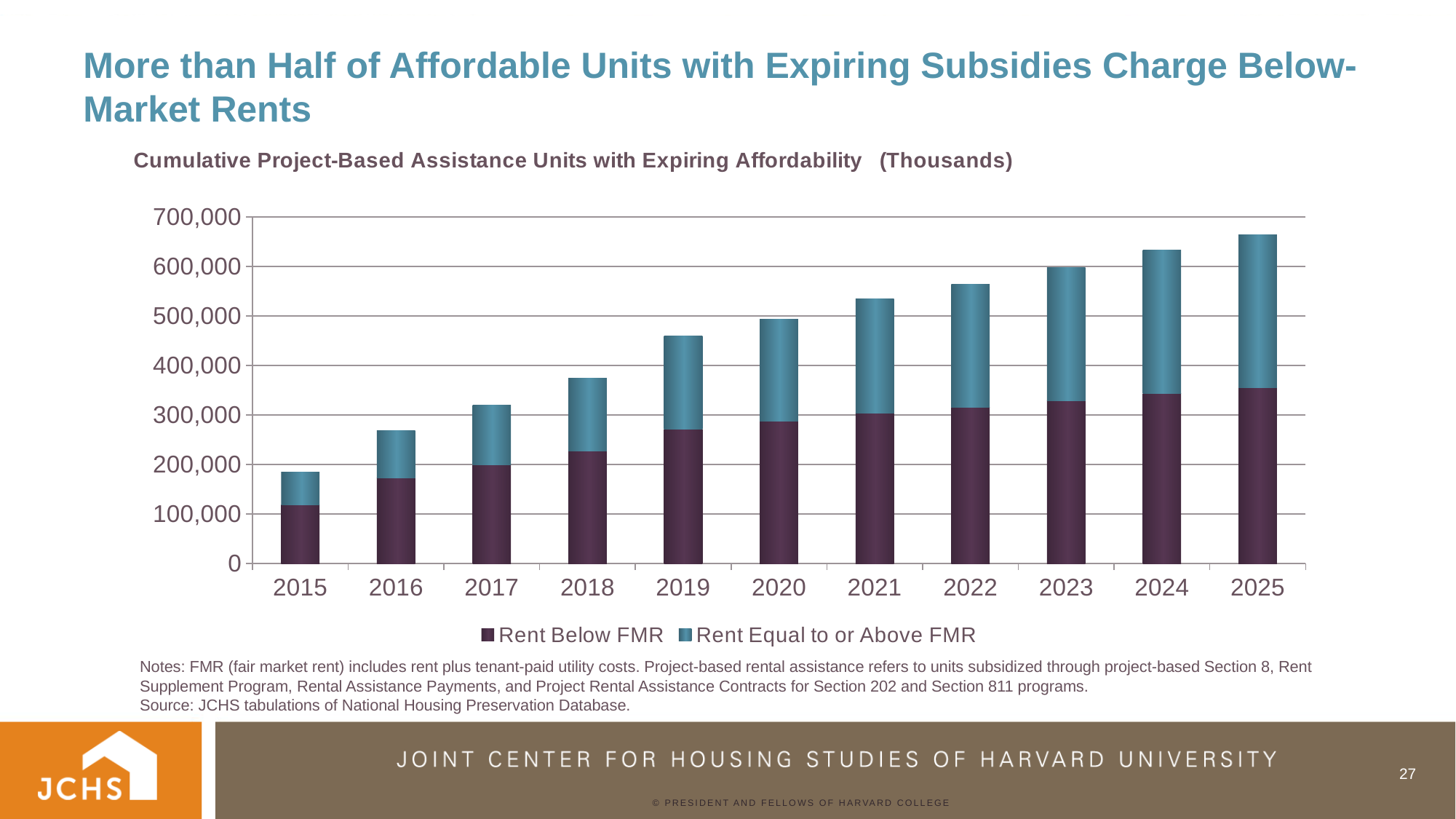
Is the total value for 2015 greater or less than 200,000? less Is the Rent Below FMR value for 2016 greater or less than 200,000? less How many years are shown on the x axis? 11 Is the Rent Below FMR value for 2025 greater or less than 300,000? greater Do the total bar heights rise or fall from 2015 to 2025? rise Which series is shown in the darker purple colour at the bottom of each bar? Rent Below FMR How many series does the legend list? 2 What kind of chart is shown on the slide? bar chart Which year has the highest total of cumulative units with expiring affordability? 2025 Which year has the lowest total of cumulative units with expiring affordability? 2015